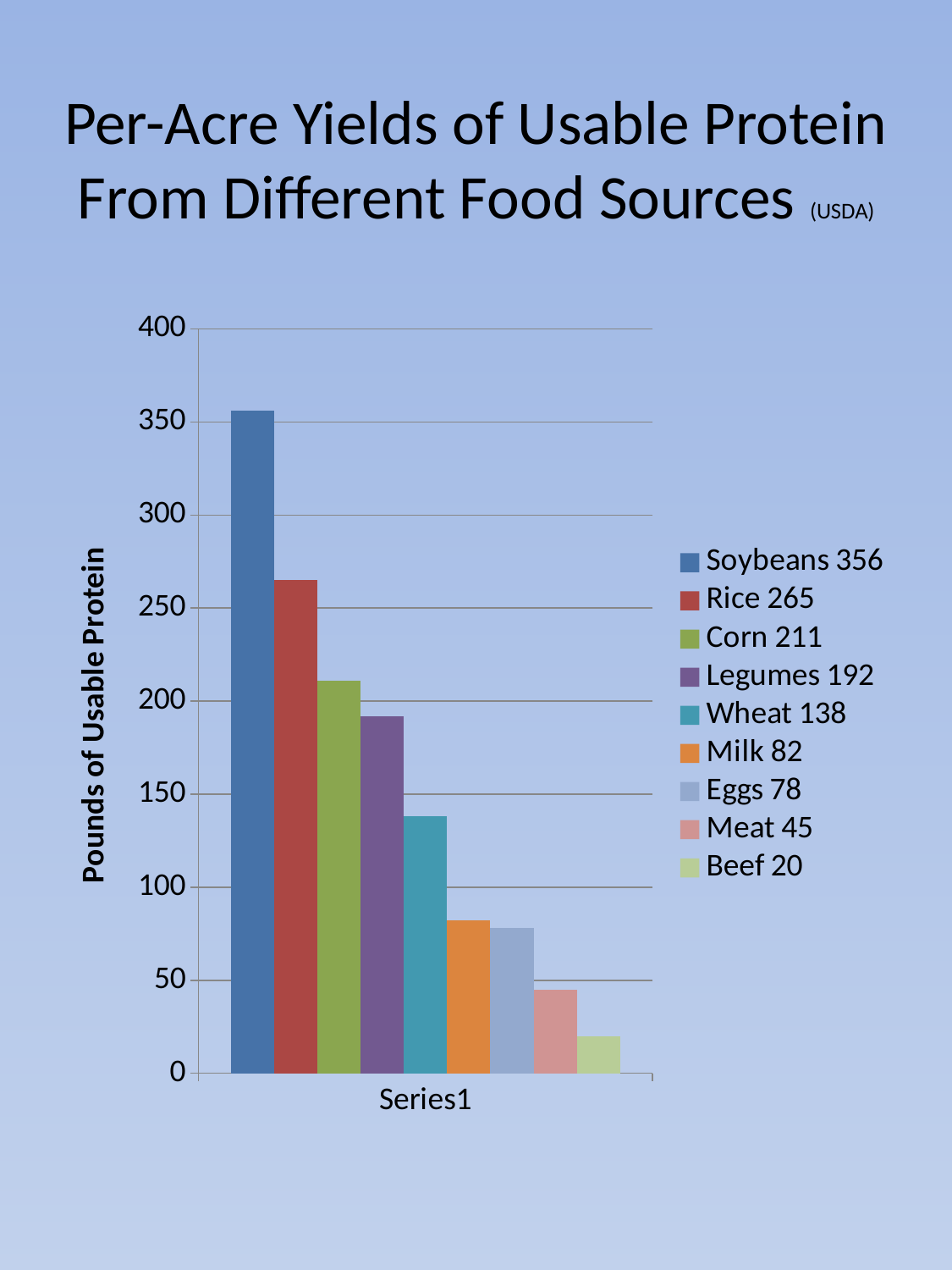
What is the per-acre yield of usable protein for Beef? 20 What kind of chart is shown on the slide? Bar chart What is the per-acre yield of usable protein for Soybeans? 356 What is the difference between the yields for Soybeans and Beef? 336 How many food sources are shown in the chart? 9 What is the label on the vertical axis of the chart? Pounds of Usable Protein Which food source has the highest per-acre yield of usable protein? Soybeans Is the value for Legumes greater or less than 150? greater What is the difference between the yields for Rice and Corn? 54 What is the per-acre yield of usable protein for Wheat? 138 Which food source has the lowest per-acre yield of usable protein? Beef Which has a higher per-acre yield of usable protein, Milk or Meat? Milk